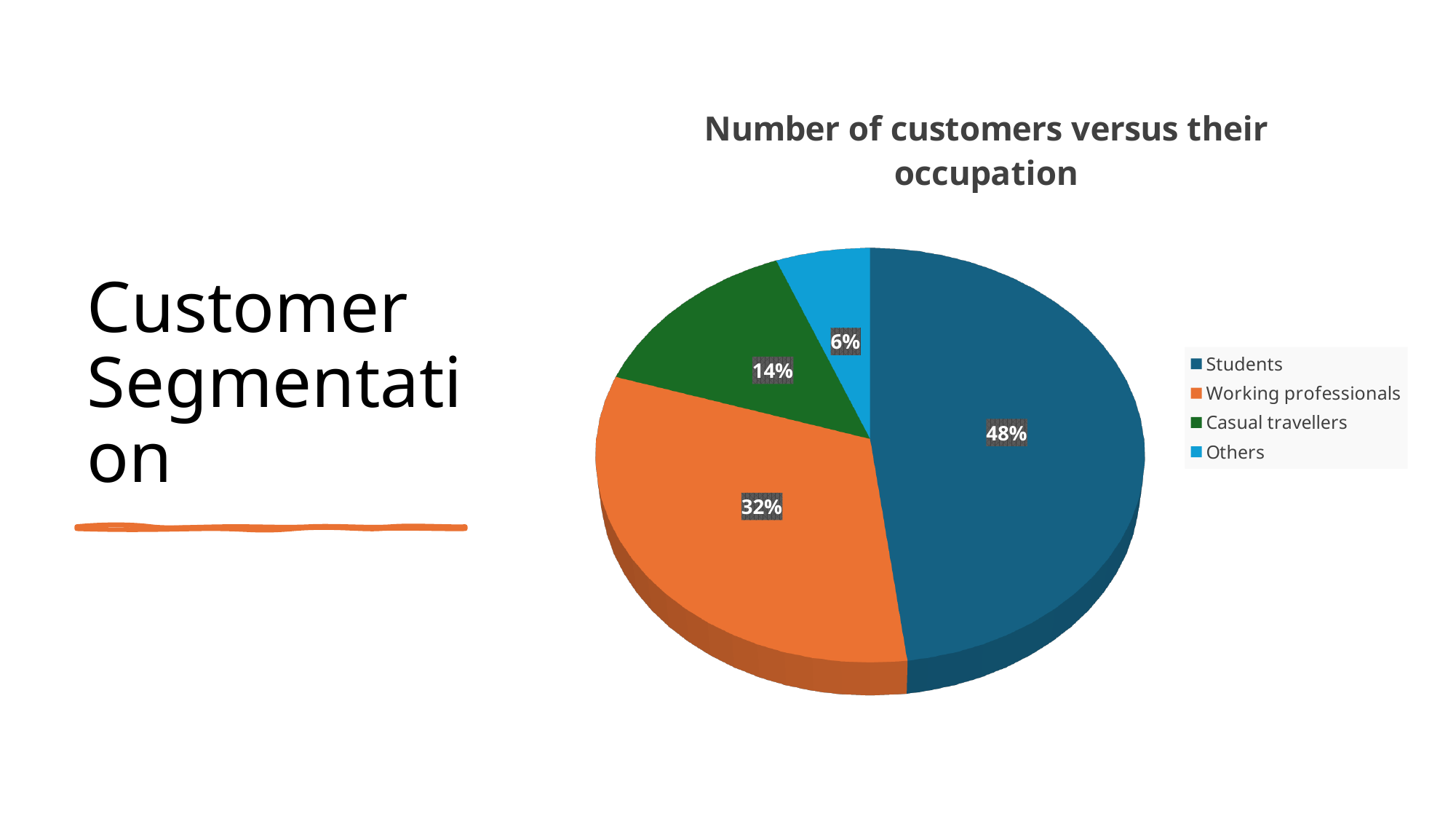
What is the difference in share between Casual travellers and Others? 8% Which has a larger share, Working professionals or Casual travellers? Working professionals How many occupation categories are shown in the pie chart? 4 What share of customers are Others? 6% What is the difference in share between Students and Working professionals? 16% Which occupation has the largest share of customers? Students What share of customers are Working professionals? 32% What is the title of the chart? Number of customers versus their occupation Which occupation has the smallest share of customers? Others What share of customers are Students? 48% What kind of chart is shown on the slide? Pie chart